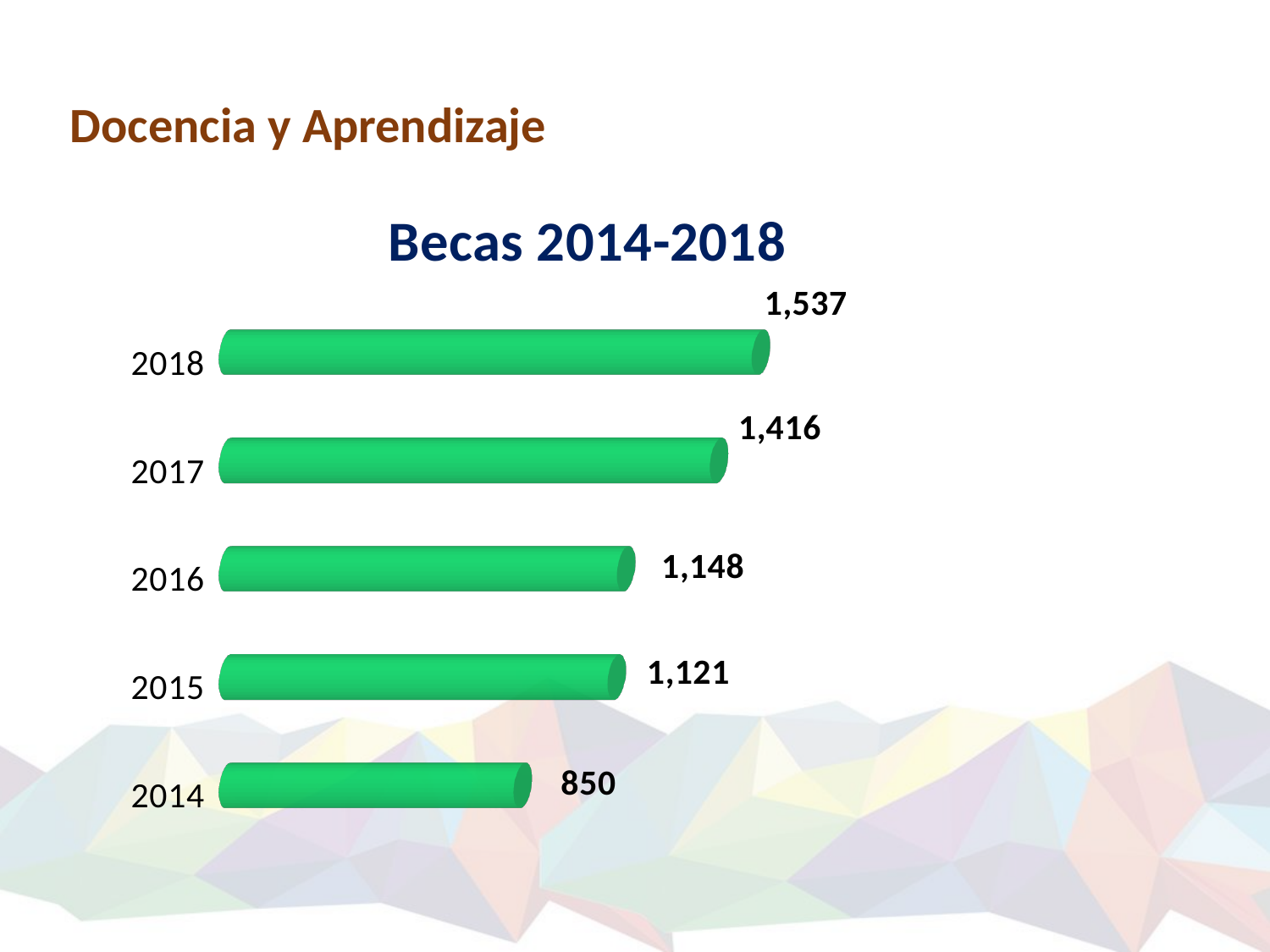
Which year has the lowest value? 2014 How many years are shown in the chart? 5 Do the values rise or fall from 2014 to 2018? rise Which is larger, the value for 2017 or the value for 2016? 2017 What is the title of the chart? Becas 2014-2018 What is the value for 2016? 1,148 What kind of chart is shown? bar chart What is the value for 2018? 1,537 What is the value for 2014? 850 What is the difference between the values for 2018 and 2017? 121 What is the difference between the values for 2015 and 2014? 271 Which year has the highest value? 2018